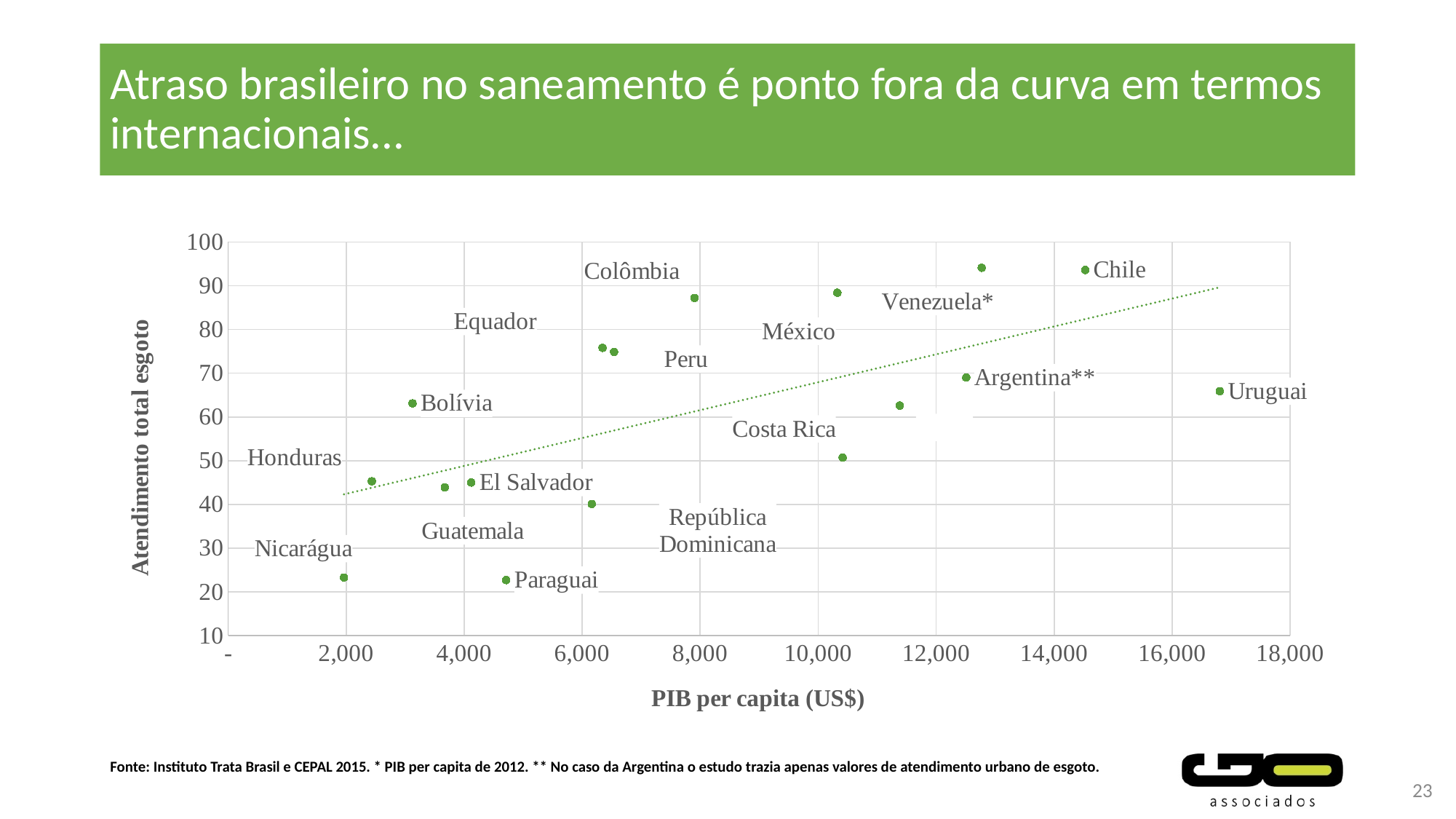
What kind of chart is shown on the slide? scatter chart What is the title of the y axis of the chart? Atendimento total esgoto Is the Atendimento total esgoto value for Bolívia greater or less than 60? greater Which has a higher Atendimento total esgoto value, Chile or Uruguai? Chile Is the PIB per capita for Uruguai greater or less than 16,000? greater Which country has the highest PIB per capita in the chart? Uruguai Is the Atendimento total esgoto value for Chile greater or less than 90? greater Which country has the lowest PIB per capita in the chart? Nicarágua What is the title of the x axis of the chart? PIB per capita (US$) Does the dotted trend line show Atendimento total esgoto rising or falling as PIB per capita increases? rising